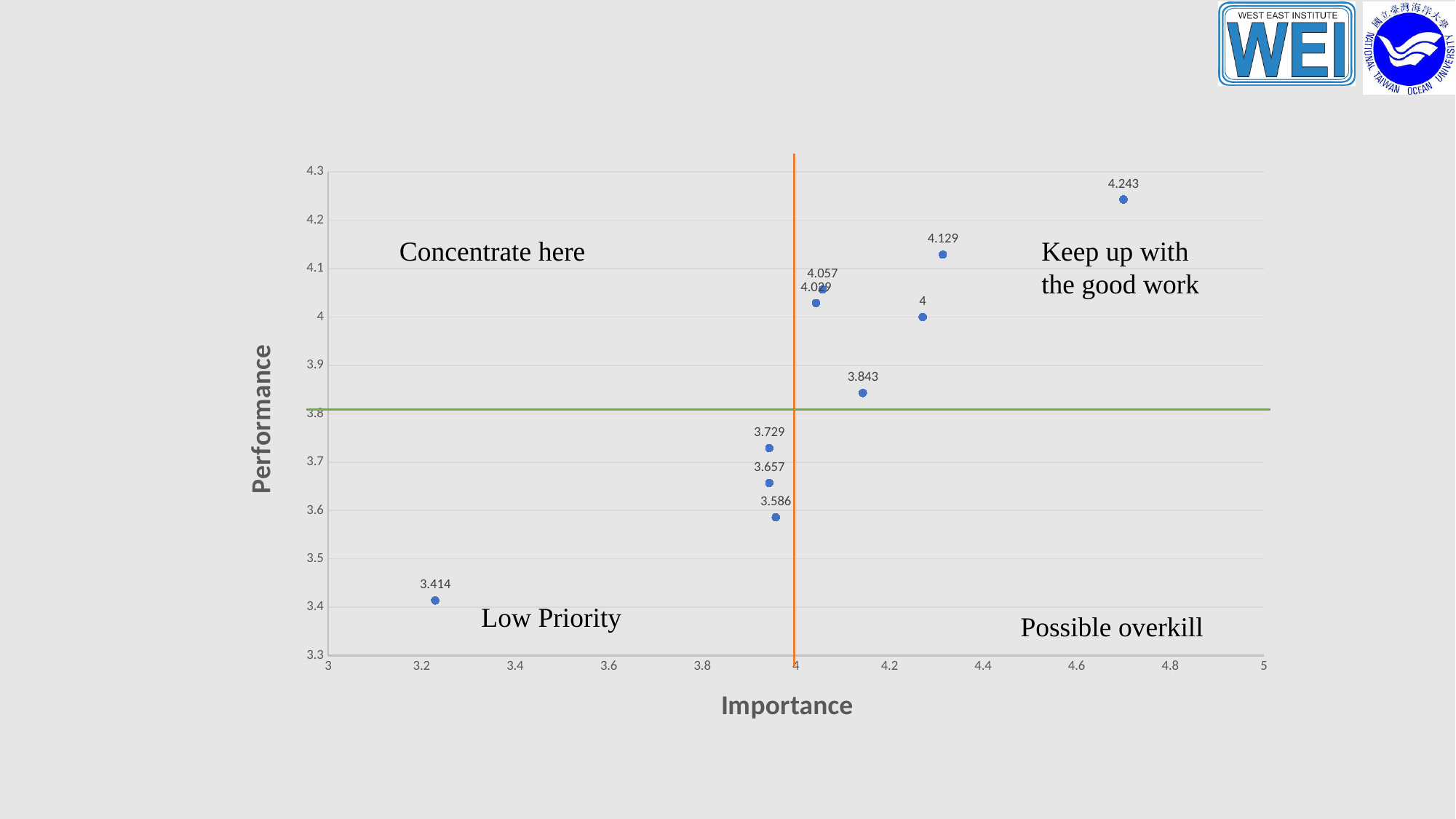
How many points have a labeled performance value below 3.8? 4 What is the title of the x axis? Importance What kind of chart is shown on the slide? scatter chart What is the highest performance value labeled on the chart? 4.243 What is the lowest performance value labeled on the chart? 3.414 What is the difference between the highest labeled value (4.243) and the lowest labeled value (3.414)? 0.829 Is the importance value of the point labeled 3.414 greater or less than 3.4? less Which labeled value is larger, 4.129 or 4.057? 4.129 Is the importance value of the point labeled 4.243 greater or less than 4.6? greater How many data points are plotted on the chart? 10 What label is shown in the top-left quadrant of the chart? Concentrate here How many points have a labeled performance value above 4? 4